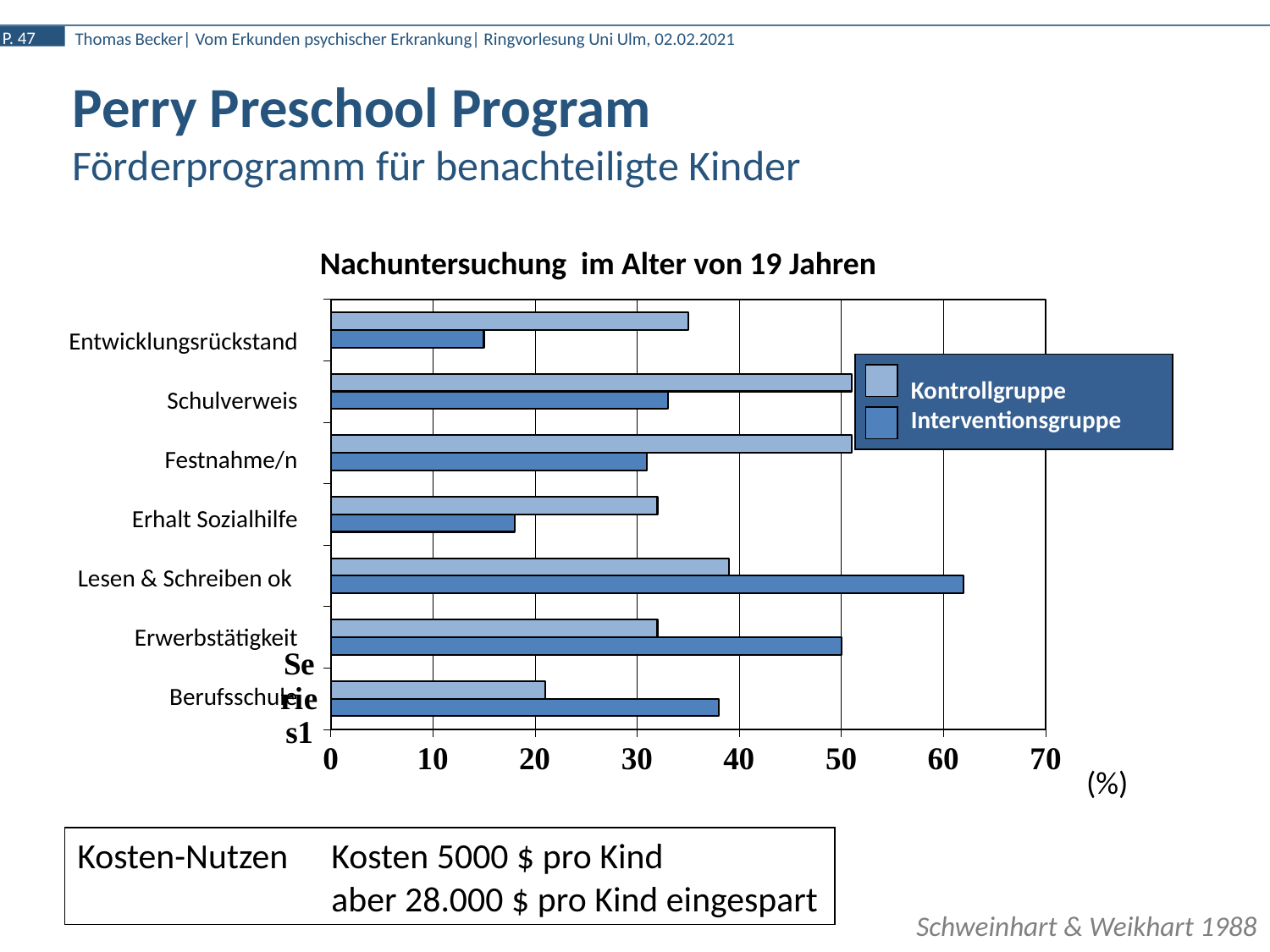
Is the Kontrollgruppe value for 'Berufsschule' greater or less than 30? less Is the Interventionsgruppe value for 'Erwerbstätigkeit' greater or less than 40? greater How many categories are shown on the vertical axis of the chart? 7 How many series does the legend of the chart list? 2 What kind of chart is shown under the title 'Nachuntersuchung im Alter von 19 Jahren'? bar chart For 'Entwicklungsrückstand', which group has the larger value, Kontrollgruppe or Interventionsgruppe? Kontrollgruppe Is the Interventionsgruppe value for 'Lesen & Schreiben ok' greater or less than 50? greater Which category has the highest value for the Interventionsgruppe? Lesen & Schreiben ok For 'Lesen & Schreiben ok', which group has the larger value, Kontrollgruppe or Interventionsgruppe? Interventionsgruppe Which category has the lowest value for the Kontrollgruppe? Berufsschule What unit is indicated for the horizontal axis of the chart? (%)